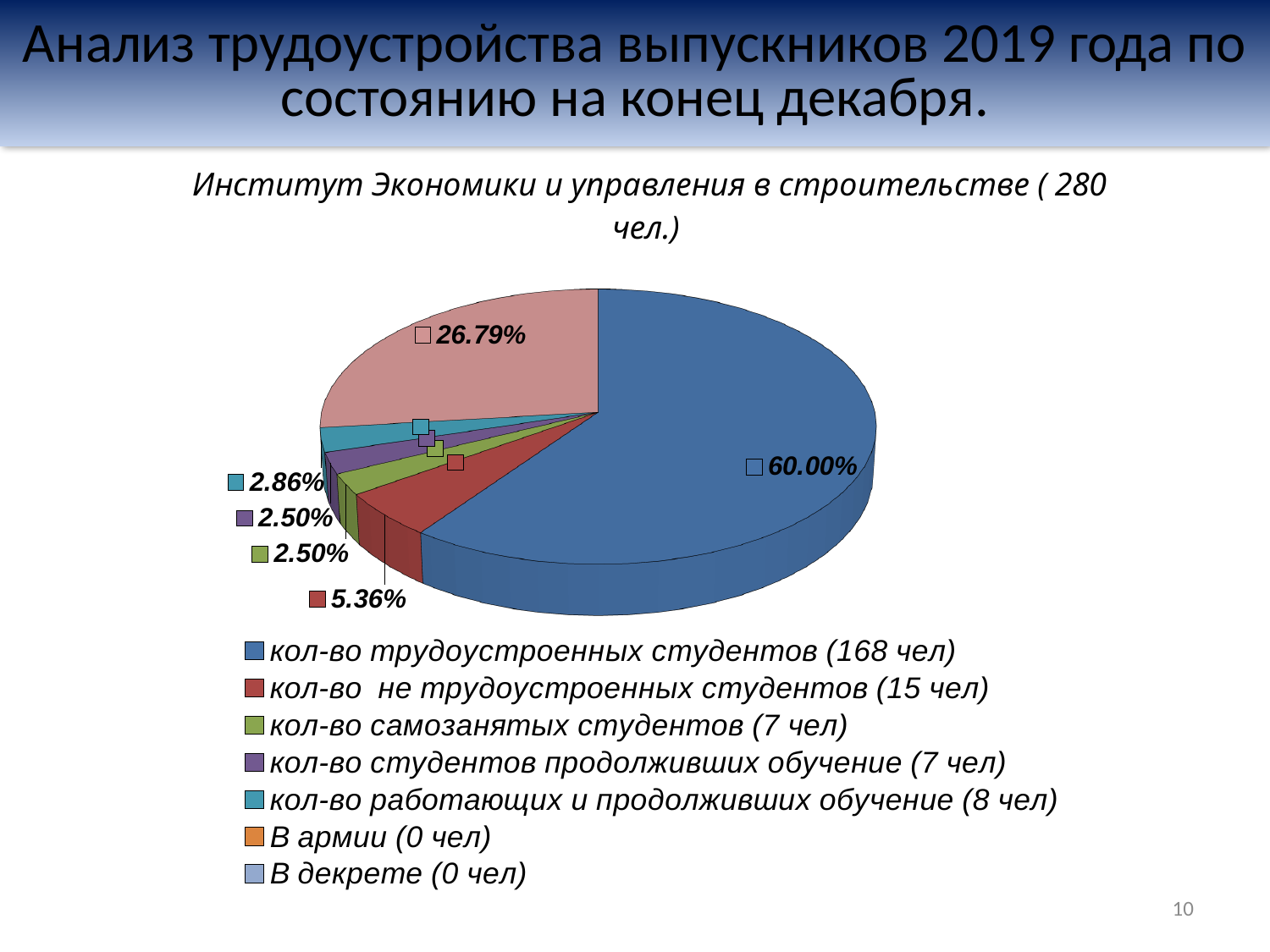
Which category has the largest slice of the pie? кол-во трудоустроенных студентов (168 чел) How many students are listed in the legend for "кол-во трудоустроенных студентов"? 168 чел What percentage share does the slice for "кол-во не трудоустроенных студентов" have? 5.36% What kind of chart is shown on the slide? pie chart What total number of people is given in the chart title? 280 чел. What percentage share does the slice for "кол-во самозанятых студентов" have? 2.50% What percentage share does the slice for "кол-во работающих и продолживших обучение" have? 2.86% How many students are listed in the legend for "кол-во не трудоустроенных студентов"? 15 чел Which is larger: the share for "кол-во не трудоустроенных студентов" or the share for "кол-во работающих и продолживших обучение"? кол-во не трудоустроенных студентов How many entries does the legend list? 7 What is the difference in percentage points between the 60.00% slice and the 26.79% slice? 33.21